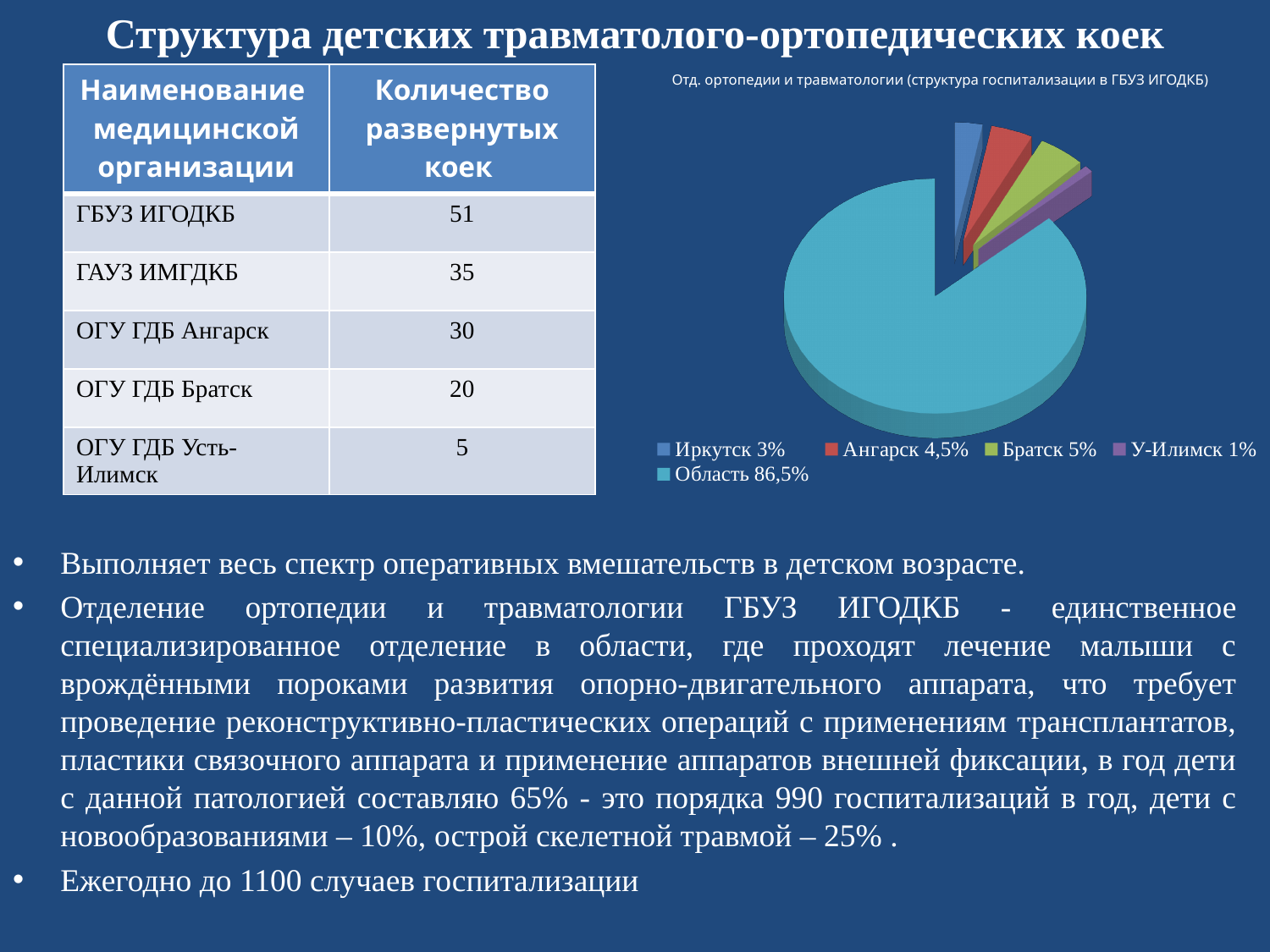
What share of the pie chart does Братск have? 5% What is the title of the pie chart? Отд. ортопедии и травматологии (структура госпитализации в ГБУЗ ИГОДКБ) What share of the pie chart does Иркутск have? 3% Which category has the largest slice in the pie chart? Область Which is larger in the pie chart, the share for Братск or the share for Ангарск? Братск What is the difference between the shares of Братск and Иркутск in the pie chart? 2% What is the difference between the shares of Ангарск and У-Илимск in the pie chart? 3,5% How many categories does the pie chart show? 5 What share of the pie chart does Область have? 86,5% Which category has the smallest slice in the pie chart? У-Илимск What kind of chart is shown on the slide? pie chart What share of the pie chart does Ангарск have? 4,5%